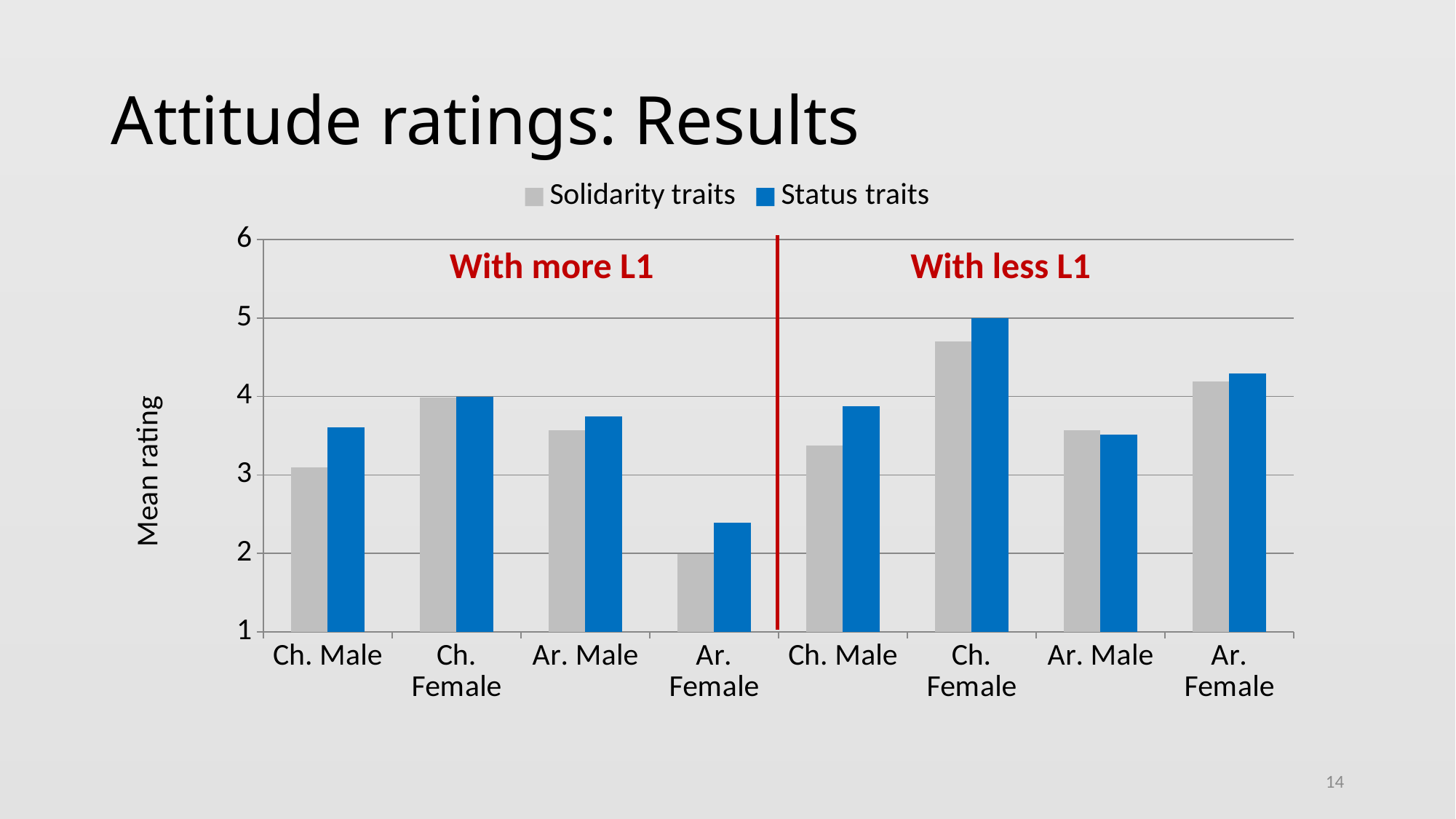
Which bar has the highest mean rating on the chart? Status traits for Ch. Female (With less L1) What kind of chart is shown on the slide? bar chart What is the label of the y axis? Mean rating How many series does the legend list? 2 Is the Status traits value for Ar. Female in the 'With more L1' section greater or less than 3? less Which bar has the lowest mean rating on the chart? Solidarity traits for Ar. Female (With more L1) For Ch. Male in the 'With less L1' section, which is larger: Solidarity traits or Status traits? Status traits How many category groups are plotted along the x axis? 8 What is the Status traits mean rating for Ch. Female in the 'With less L1' section? 5 Is the Solidarity traits value for Ch. Male in the 'With more L1' section greater or less than 3? greater